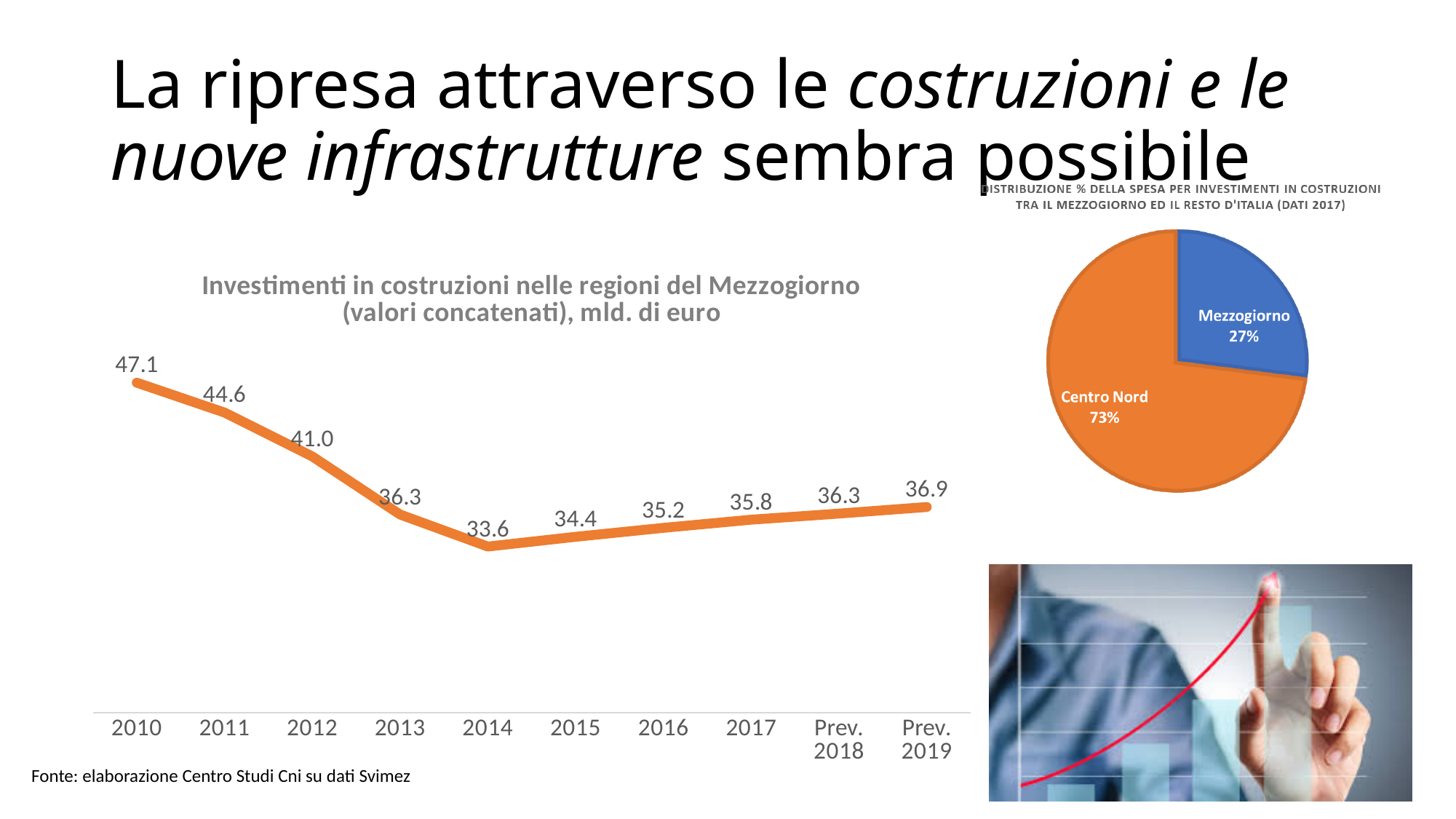
In the line chart 'Investimenti in costruzioni nelle regioni del Mezzogiorno', which year has the lowest value? 2014 In the line chart 'Investimenti in costruzioni nelle regioni del Mezzogiorno', what is the difference between the 2010 value and the 2014 value? 13.5 What kind of chart is the chart titled 'Investimenti in costruzioni nelle regioni del Mezzogiorno'? line chart In the line chart 'Investimenti in costruzioni nelle regioni del Mezzogiorno', what is the value for Prev. 2019? 36.9 In the pie chart on the right, what share does Mezzogiorno have? 27% In the line chart 'Investimenti in costruzioni nelle regioni del Mezzogiorno', how many data points are plotted? 10 In the pie chart on the right, what share does Centro Nord have? 73% In the line chart 'Investimenti in costruzioni nelle regioni del Mezzogiorno', what is the value for 2014? 33.6 In the line chart 'Investimenti in costruzioni nelle regioni del Mezzogiorno', what is the value for 2010? 47.1 In the line chart 'Investimenti in costruzioni nelle regioni del Mezzogiorno', do the values rise or fall from 2014 to Prev. 2019? rise In the line chart 'Investimenti in costruzioni nelle regioni del Mezzogiorno', which is larger, the value for 2012 or the value for 2017? 2012 In the line chart 'Investimenti in costruzioni nelle regioni del Mezzogiorno', which year has the highest value? 2010